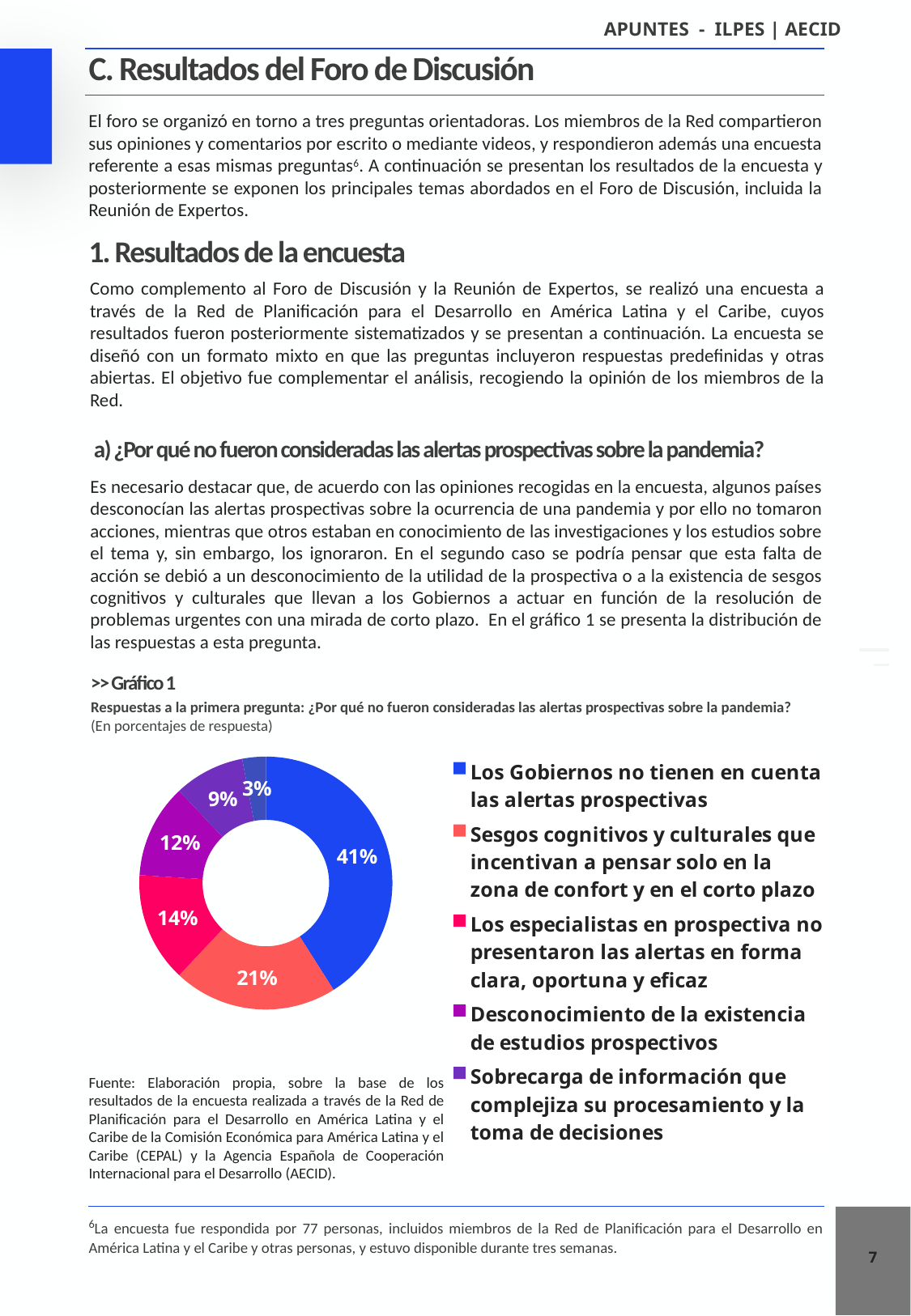
What is the smallest percentage shown on the chart? 3% What percentage of responses corresponds to 'Sesgos cognitivos y culturales que incentivan a pensar solo en la zona de confort y en el corto plazo'? 21% What percentage of responses corresponds to 'Sobrecarga de información que complejiza su procesamiento y la toma de decisiones'? 9% What type of chart is shown in Gráfico 1? Pie (donut) chart How many entries does the legend list? 5 What percentage of responses corresponds to 'Los especialistas en prospectiva no presentaron las alertas en forma clara, oportuna y eficaz'? 14% What percentage of responses corresponds to 'Los Gobiernos no tienen en cuenta las alertas prospectivas'? 41% Which response category has the largest share in the chart? Los Gobiernos no tienen en cuenta las alertas prospectivas Which has a larger share: 'Desconocimiento de la existencia de estudios prospectivos' or 'Sobrecarga de información que complejiza su procesamiento y la toma de decisiones'? Desconocimiento de la existencia de estudios prospectivos How many slices does the chart have? 6 What is the difference in percentage points between 'Los Gobiernos no tienen en cuenta las alertas prospectivas' and 'Sesgos cognitivos y culturales que incentivan a pensar solo en la zona de confort y en el corto plazo'? 20 percentage points What percentage of responses corresponds to 'Desconocimiento de la existencia de estudios prospectivos'? 12%